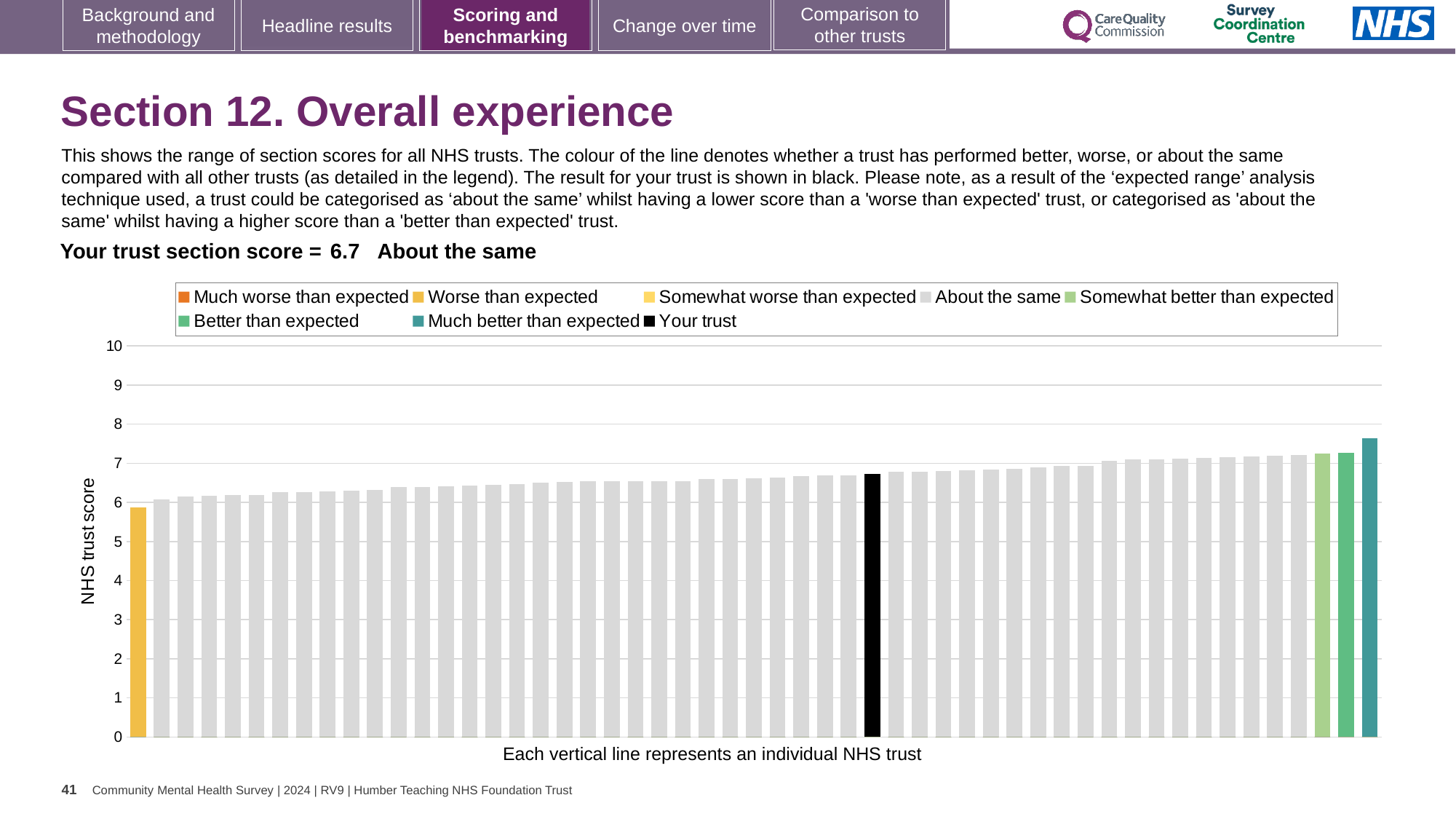
Do the bar values rise or fall from left to right across the chart? rise What is the section score for your trust shown on the slide? 6.7 Is the value of the black 'Your trust' bar greater or less than 6? greater What is the label on the vertical axis of the chart? NHS trust score Which is larger: the black 'Your trust' bar or the leftmost yellow bar? the black 'Your trust' bar What kind of chart is shown on the slide? bar chart How many entries does the chart legend list? 8 Which legend category does the lowest bar in the chart belong to? Worse than expected What colour is used for the 'Your trust' bar in the chart? black Is the value of the leftmost (yellow) bar greater or less than 7? less Which legend category does the highest bar in the chart belong to? Much better than expected Is the value of the rightmost (teal) bar greater or less than 7? greater